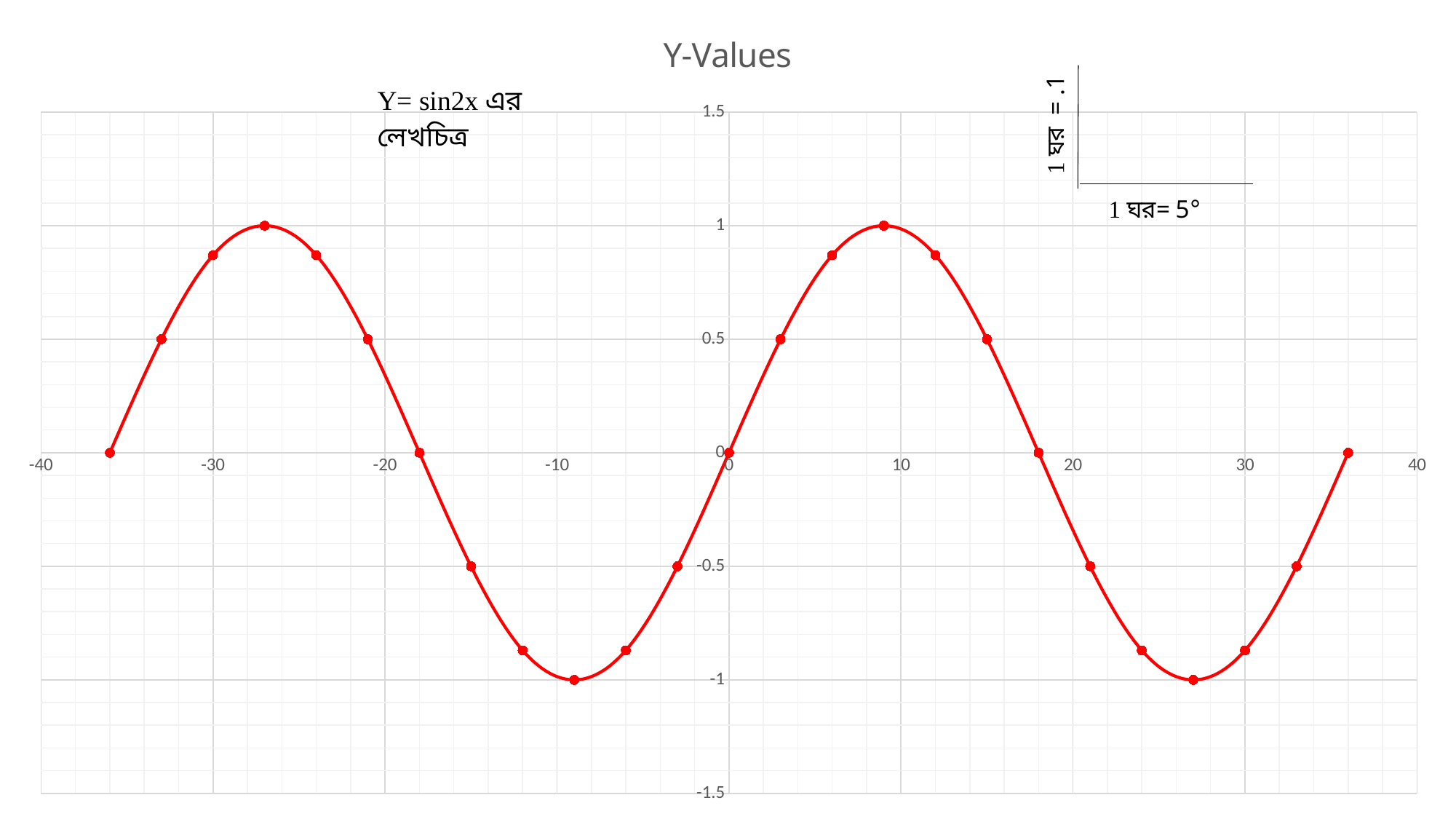
What is the title of the chart? Y-Values What is the value of the curve at x = 0? 0 Is the value of the curve at x = -30 greater or less than 0.5? greater What kind of chart is shown on the slide? line chart What is the lowest value the plotted curve reaches? -1 Between x = 10 and x = 30, does the curve rise or fall? fall Between x = 0 and x = 10, does the curve rise or fall? rise What is the highest value the plotted curve reaches? 1 Which is larger, the value of the curve at x = -30 or at x = 30? x = -30 According to the text on the slide, which function is plotted? Y= sin2x How many data points are marked on the curve? 25 Is the value of the curve at x = 30 greater or less than -0.5? less